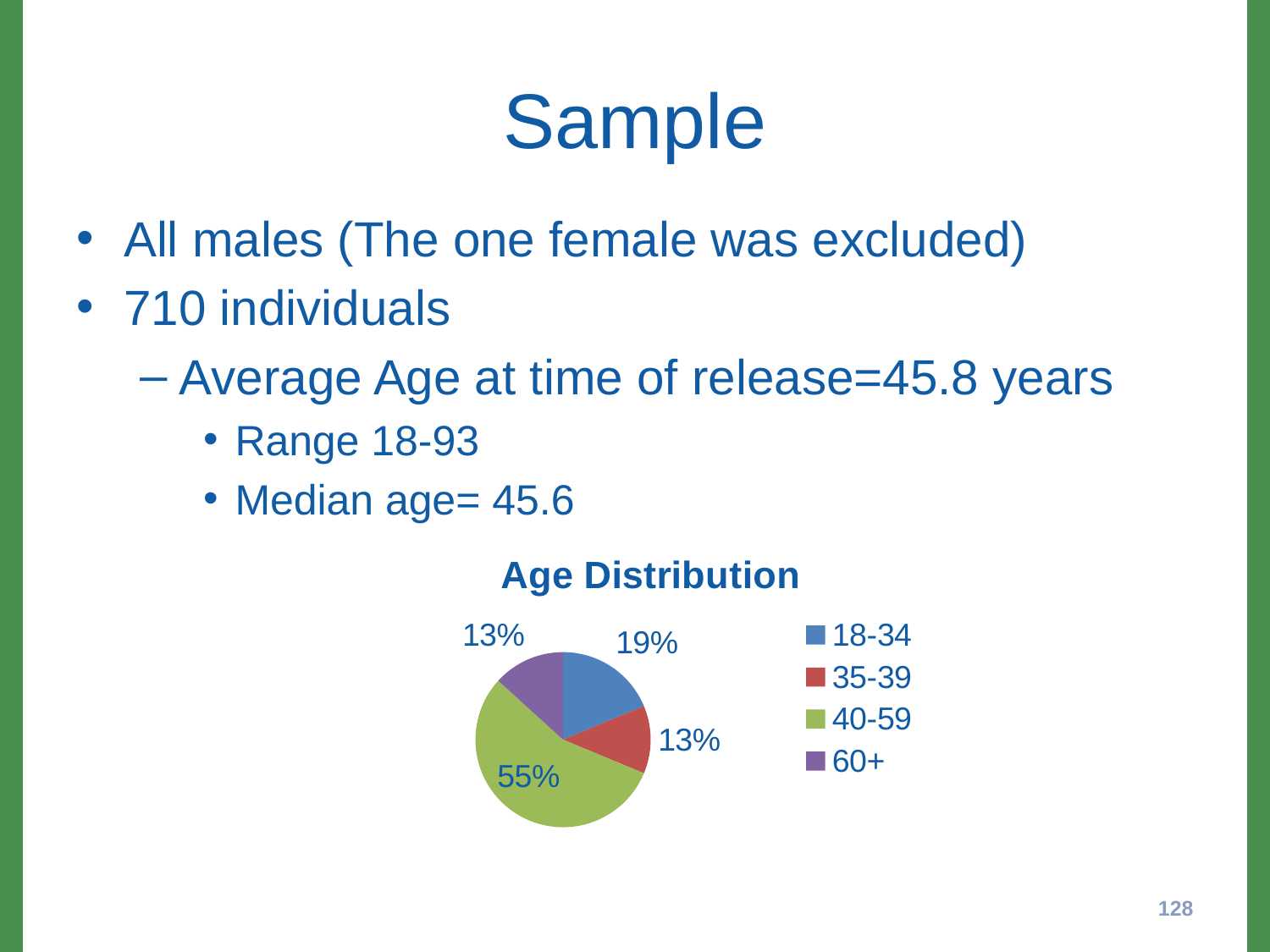
What type of chart is shown on the slide? pie chart What is the difference between the share for 40-59 and the share for 18-34? 36% How many age groups are shown in the pie chart? 4 How many entries does the legend list? 4 What share of the pie does the 18-34 age group represent? 19% What share of the pie does the 35-39 age group represent? 13% Which age group has the largest share of the pie? 40-59 What share of the pie does the 60+ age group represent? 13% Which is larger, the share for 18-34 or the share for 60+? 18-34 What colour is the slice for the 40-59 age group? green What is the title of the chart? Age Distribution